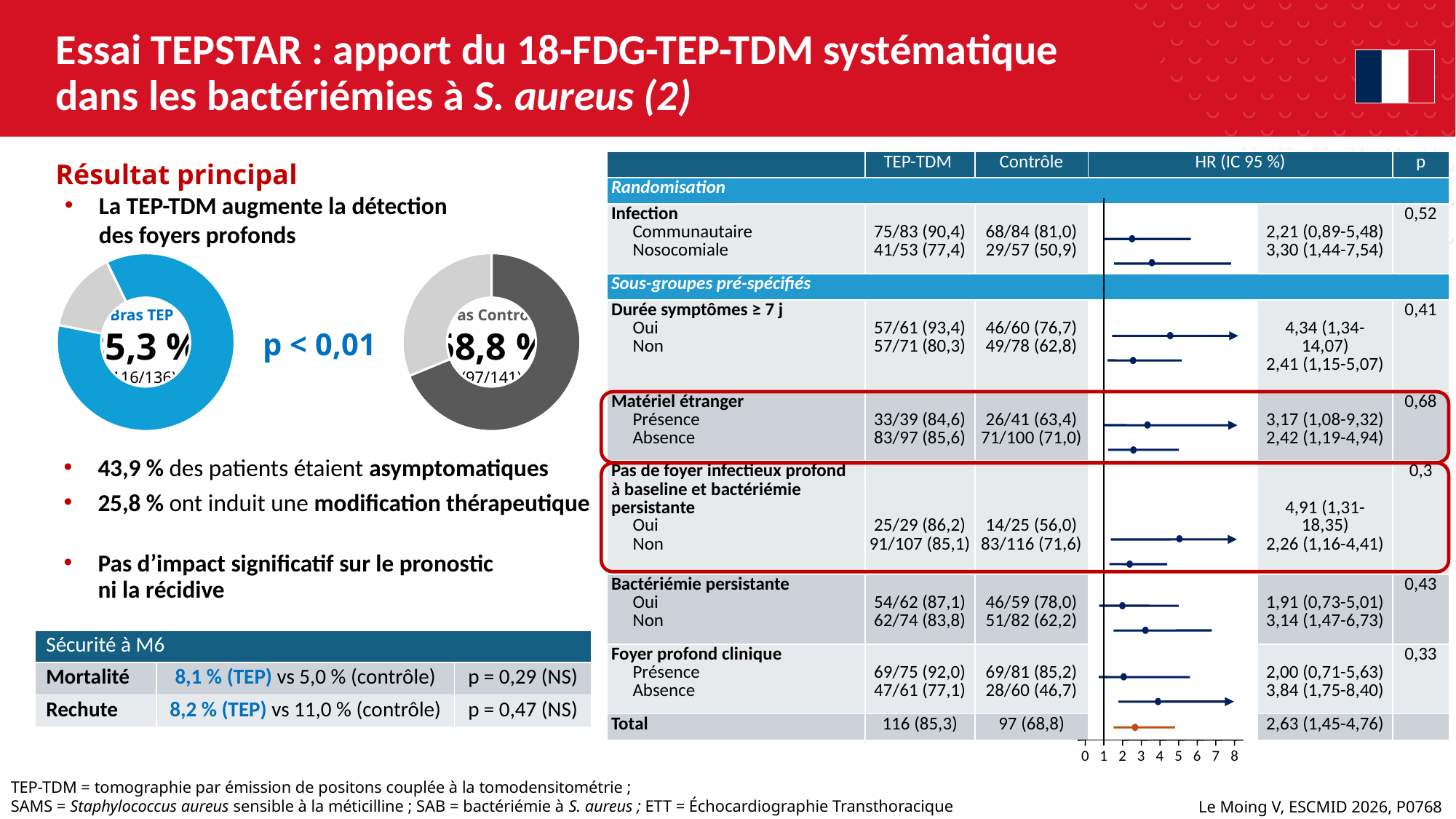
In the forest plot, what is the difference between the HR for Infection Nosocomiale and the HR for Infection Communautaire? 1,09 In the table beside the forest plot, what is the Contrôle value in the Total row? 97 (68,8) What kind of chart is shown on the right side of the slide next to the HR (IC 95 %) column? forest plot In the forest plot, which subgroup row has the highest HR point estimate? Pas de foyer infectieux profond à baseline et bactériémie persistante – Oui (4,91) In the forest plot, what is the HR (IC 95 %) for Infection Nosocomiale? 3,30 (1,44-7,54) What kind of charts are the two circular graphics under 'Résultat principal'? donut (pie) charts In the forest plot, what colour is the Total row's point and line, compared with the other rows? orange (others are dark blue) In the forest plot, which subgroup row has the lowest HR point estimate? Bactériémie persistante – Oui (1,91) In the forest plot, is the HR point estimate for the Total row greater or less than 3? less In the forest plot, which has the larger HR: Matériel étranger Présence or Matériel étranger Absence? Présence What is the maximum value shown on the x axis of the forest plot? 8 In the forest plot, what is the HR (IC 95 %) for the Total row? 2,63 (1,45-4,76)